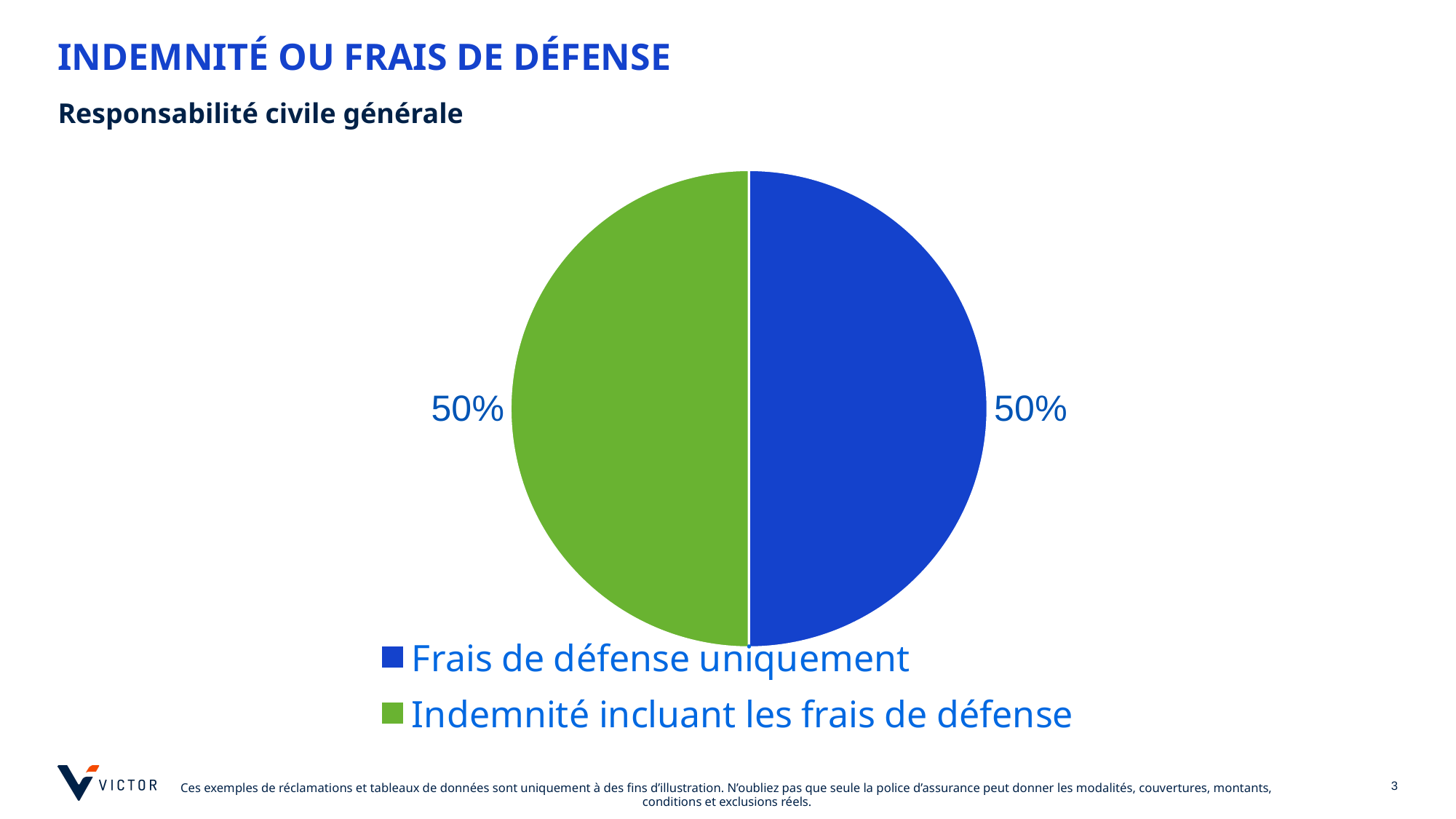
Which legend entry is shown in blue? Frais de défense uniquement What is the difference between the share for "Frais de défense uniquement" and the share for "Indemnité incluant les frais de défense"? 0% What is the total of the two slices shown in the pie chart? 100% What kind of chart is shown on the slide? pie chart Which legend entry is shown in green? Indemnité incluant les frais de défense How many entries does the legend list? 2 How many slices does the pie chart have? 2 What share of the pie does "Frais de défense uniquement" represent? 50% What share of the pie does "Indemnité incluant les frais de défense" represent? 50%